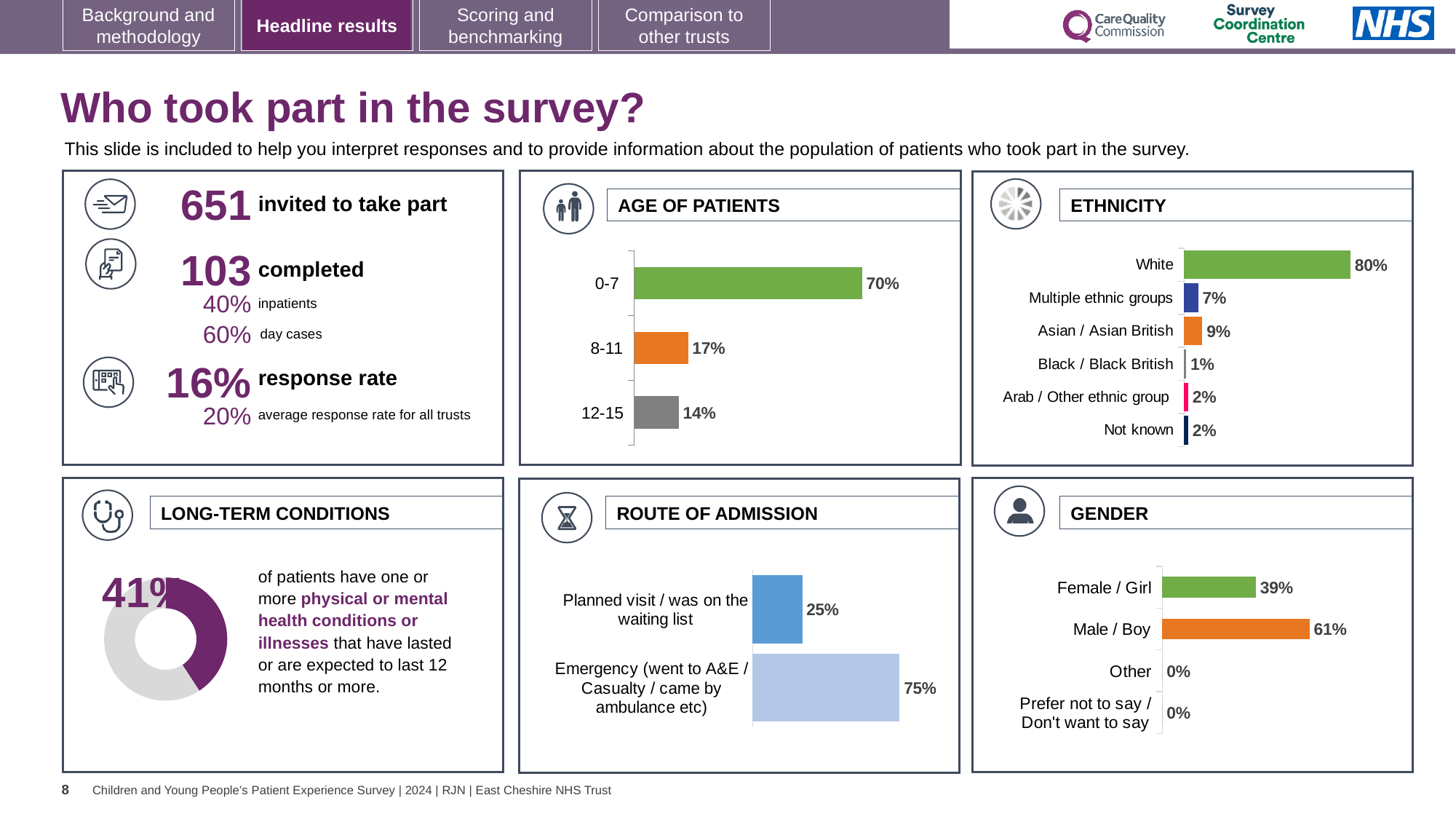
In the GENDER chart, what is the value for Male / Boy? 61% In the GENDER chart, which category has the highest value? Male / Boy In the AGE OF PATIENTS chart, which age group has the lowest value? 12-15 In the AGE OF PATIENTS chart, what is the difference between the 8-11 and 12-15 values? 3% In the AGE OF PATIENTS chart, what is the value for the 0-7 age group? 70% In the ROUTE OF ADMISSION chart, what is the value for Emergency (went to A&E / Casualty / came by ambulance etc)? 75% In the ETHNICITY chart, which is larger: Multiple ethnic groups or Asian / Asian British? Asian / Asian British In the ETHNICITY chart, how many categories are shown? 6 In the ROUTE OF ADMISSION chart, what is the difference between the Emergency and Planned visit values? 50% What kind of chart is the LONG-TERM CONDITIONS chart? Doughnut chart In the ETHNICITY chart, which category has the highest value? White In the ETHNICITY chart, what is the value for Asian / Asian British? 9%